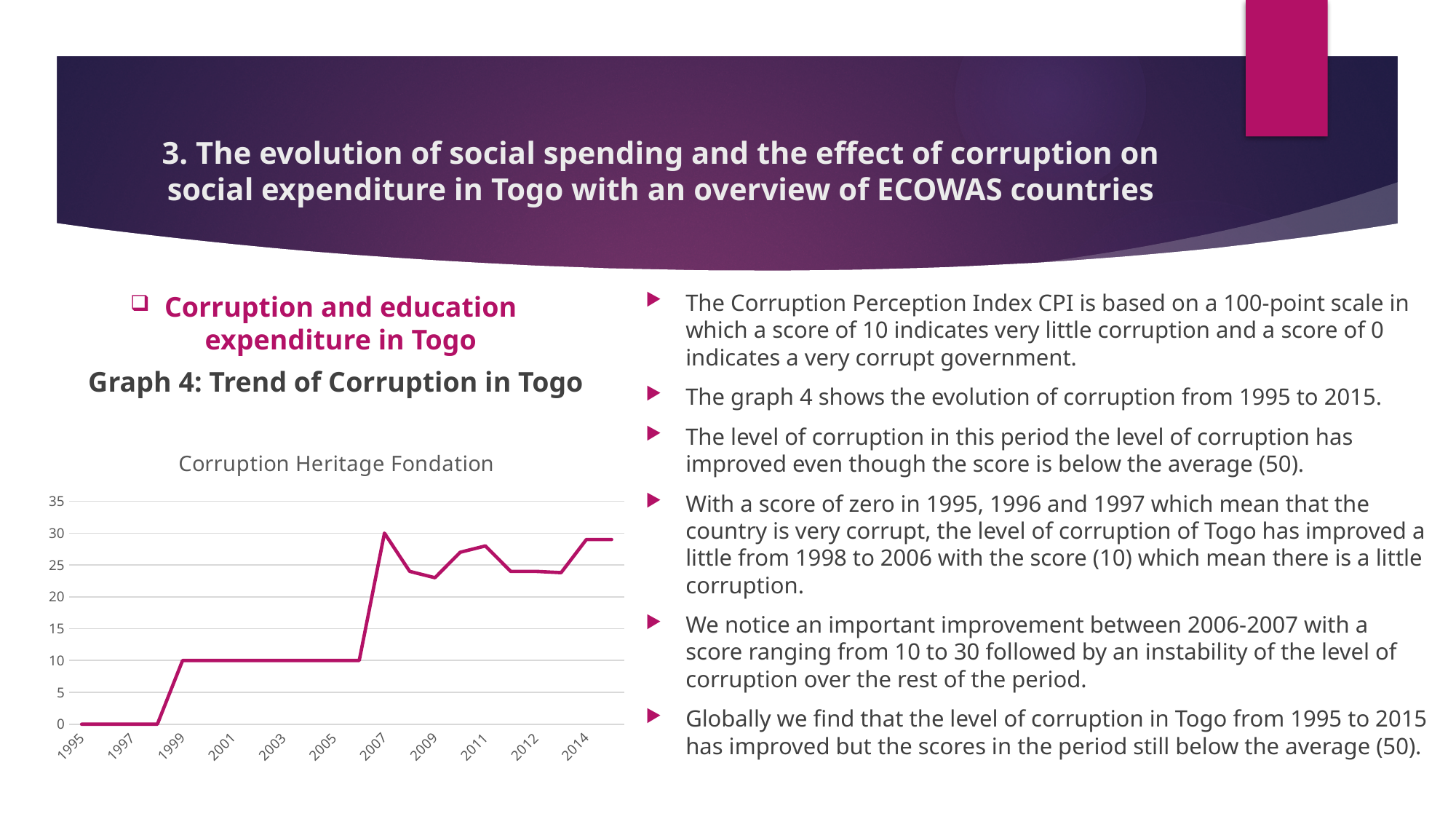
Which year has the larger value, 1997 or 1999? 1999 What is the value for 1995 in the chart? 0 What is the value for 2007 in the chart? 30 What is the difference between the value for 2007 and the value for 1999? 20 What is the value for 1999 in the chart? 10 Overall, does the line rise or fall from 1995 to 2014? rise Is the value for 2009 greater or less than 20? greater What is the title printed above the chart? Corruption Heritage Fondation How many year labels are shown on the x axis of the chart? 11 What kind of chart is shown under 'Graph 4: Trend of Corruption in Togo'? line chart Is the value for 2003 greater or less than 15? less Which year has the larger value, 2005 or 2007? 2007